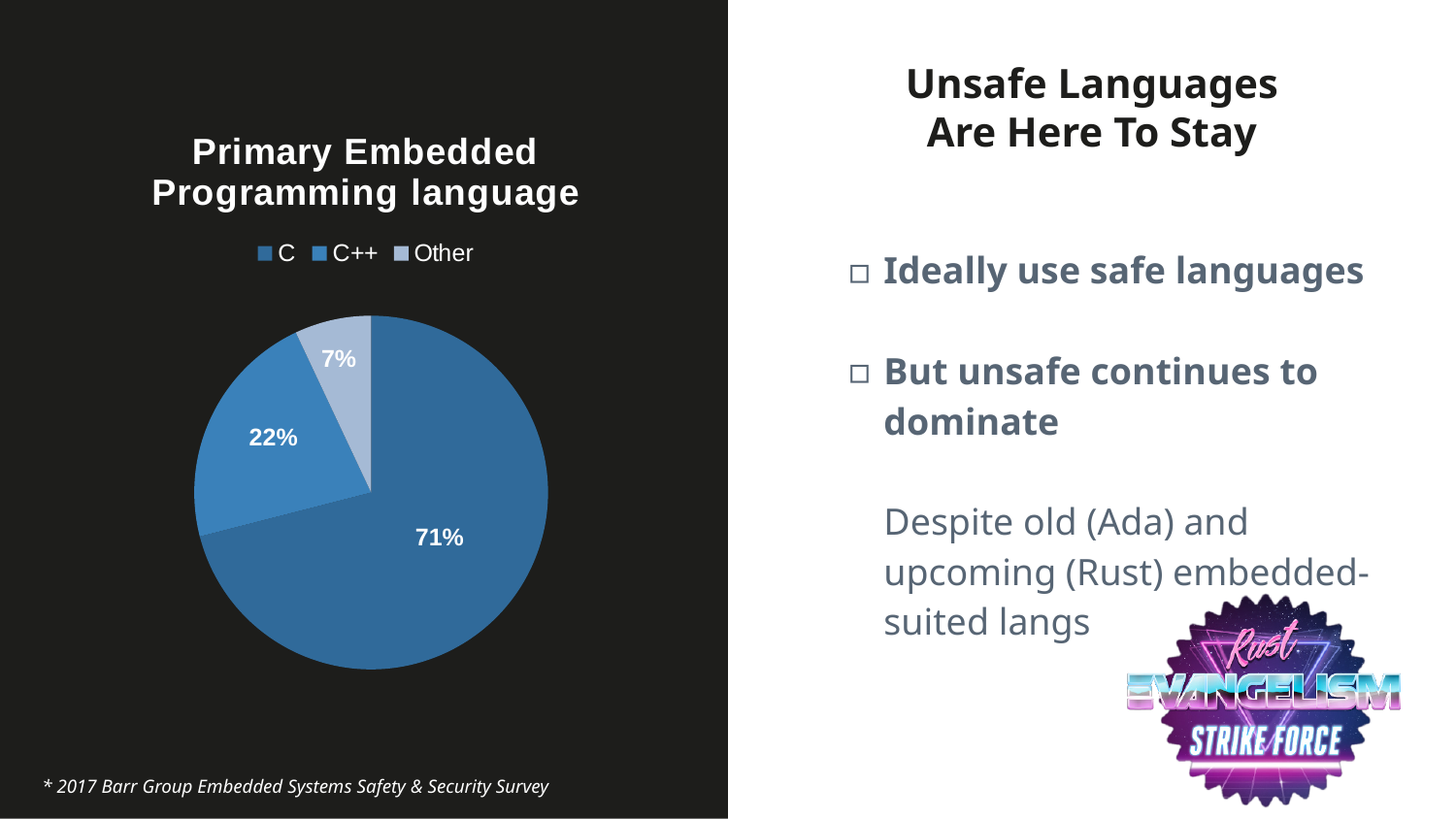
What is the title of the chart? Primary Embedded Programming language Which category has the smallest slice of the pie chart? Other What share of the pie chart does C++ account for? 22% What share of the pie chart does C account for? 71% How many categories are shown in the pie chart? 3 Which language has the largest slice of the pie chart? C What share of the pie chart does Other account for? 7% How many entries does the chart legend list? 3 What is the difference in percentage points between the C and C++ slices? 49 What is the difference in percentage points between the C++ and Other slices? 15 Which slice is larger, C++ or Other? C++ What kind of chart is shown on the slide? Pie chart